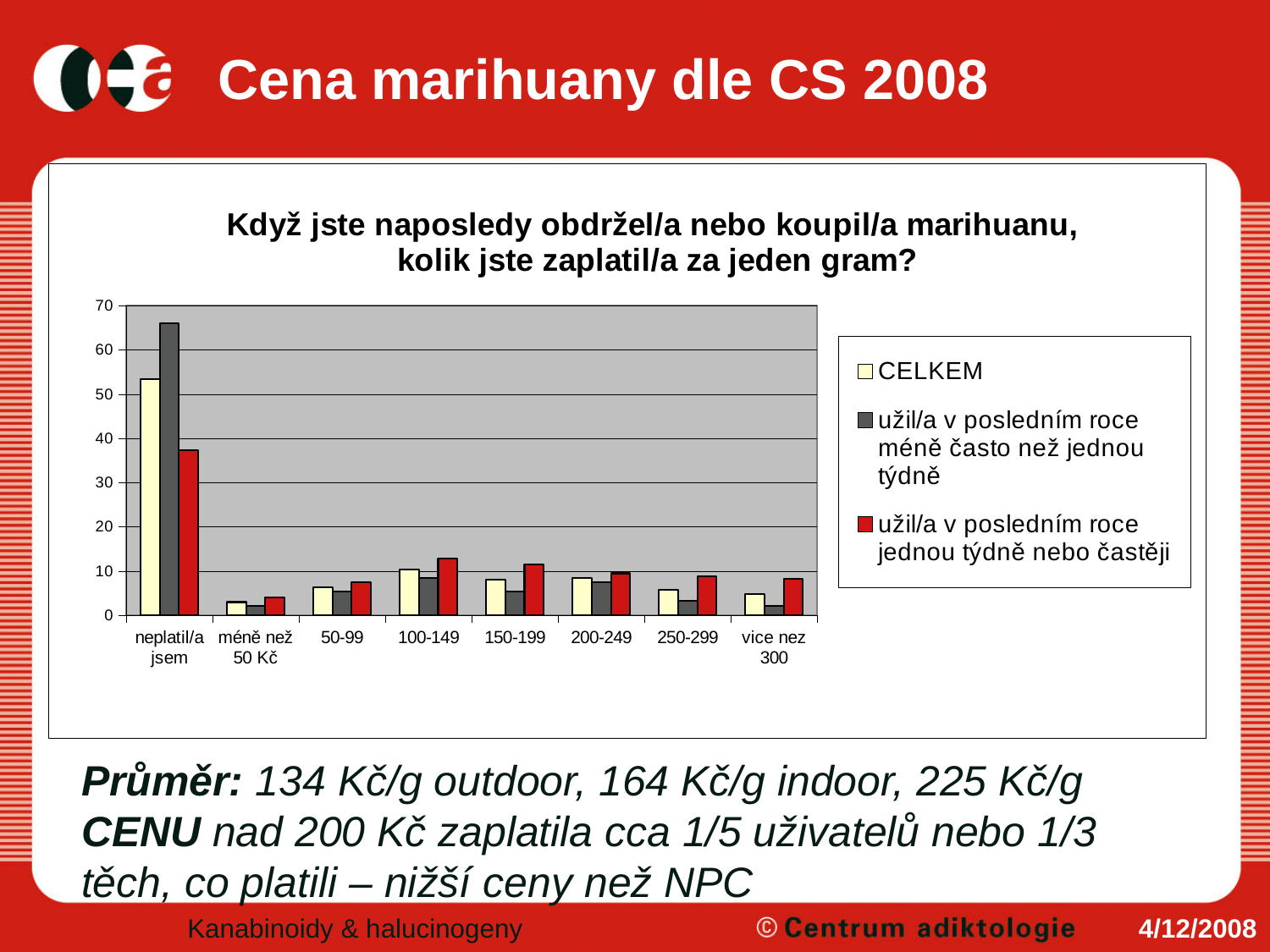
Is the value for 'užil/a v posledním roce jednou týdně nebo častěji' in the 'neplatil/a jsem' category greater or less than 40? less How many series does the legend list? 3 Which category has the highest value for the CELKEM series? neplatil/a jsem Which series has the lowest value in the 'vice nez 300' category? užil/a v posledním roce méně často než jednou týdně What colour are the bars for the CELKEM series? pale yellow In the 'neplatil/a jsem' category, which series has the larger value: 'užil/a v posledním roce méně často než jednou týdně' or 'užil/a v posledním roce jednou týdně nebo častěji'? užil/a v posledním roce méně často než jednou týdně How many price categories are shown on the x axis? 8 Is the value for 'užil/a v posledním roce méně často než jednou týdně' in the 'neplatil/a jsem' category greater or less than 60? greater Which category has the lowest value for the CELKEM series? méně než 50 Kč In the '100-149' category, which series has the larger value: CELKEM or 'užil/a v posledním roce jednou týdně nebo častěji'? užil/a v posledním roce jednou týdně nebo častěji What kind of chart is shown on the slide? bar chart Is the CELKEM value for 'neplatil/a jsem' greater or less than 50? greater